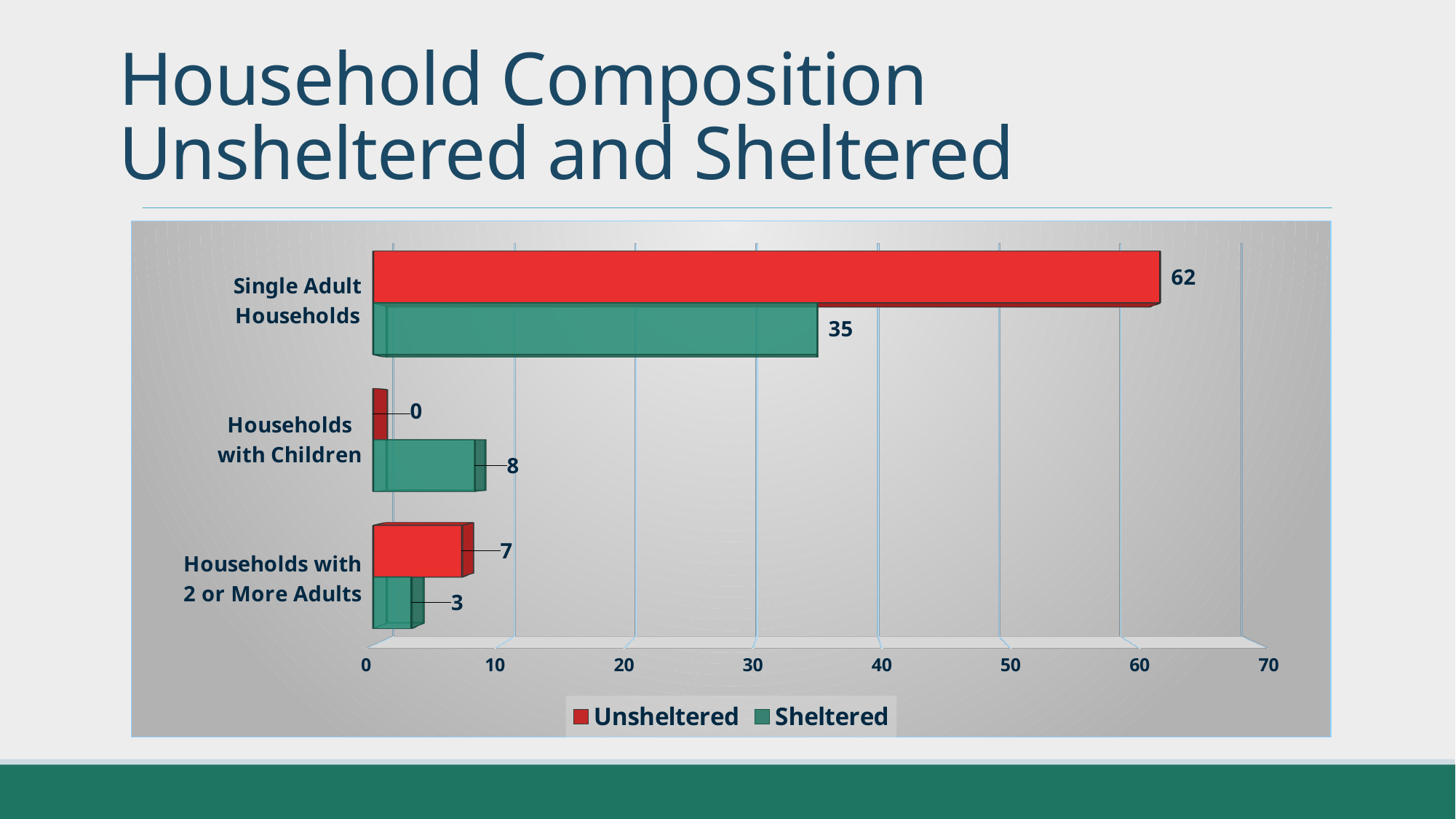
What is the difference between the Unsheltered and Sheltered values for Single Adult Households? 27 What kind of chart is shown on the slide? Bar chart What is the Unsheltered value for Single Adult Households? 62 Which category has the lowest Unsheltered value? Households with Children How many series does the legend list? 2 What is the Unsheltered value for Households with 2 or More Adults? 7 Which category has the highest Sheltered value? Single Adult Households For Households with 2 or More Adults, which is larger: the Unsheltered value or the Sheltered value? Unsheltered What is the Sheltered value for Single Adult Households? 35 What is the Sheltered value for Households with Children? 8 Which colour represents the Sheltered series? Green How many categories are shown on the chart? 3